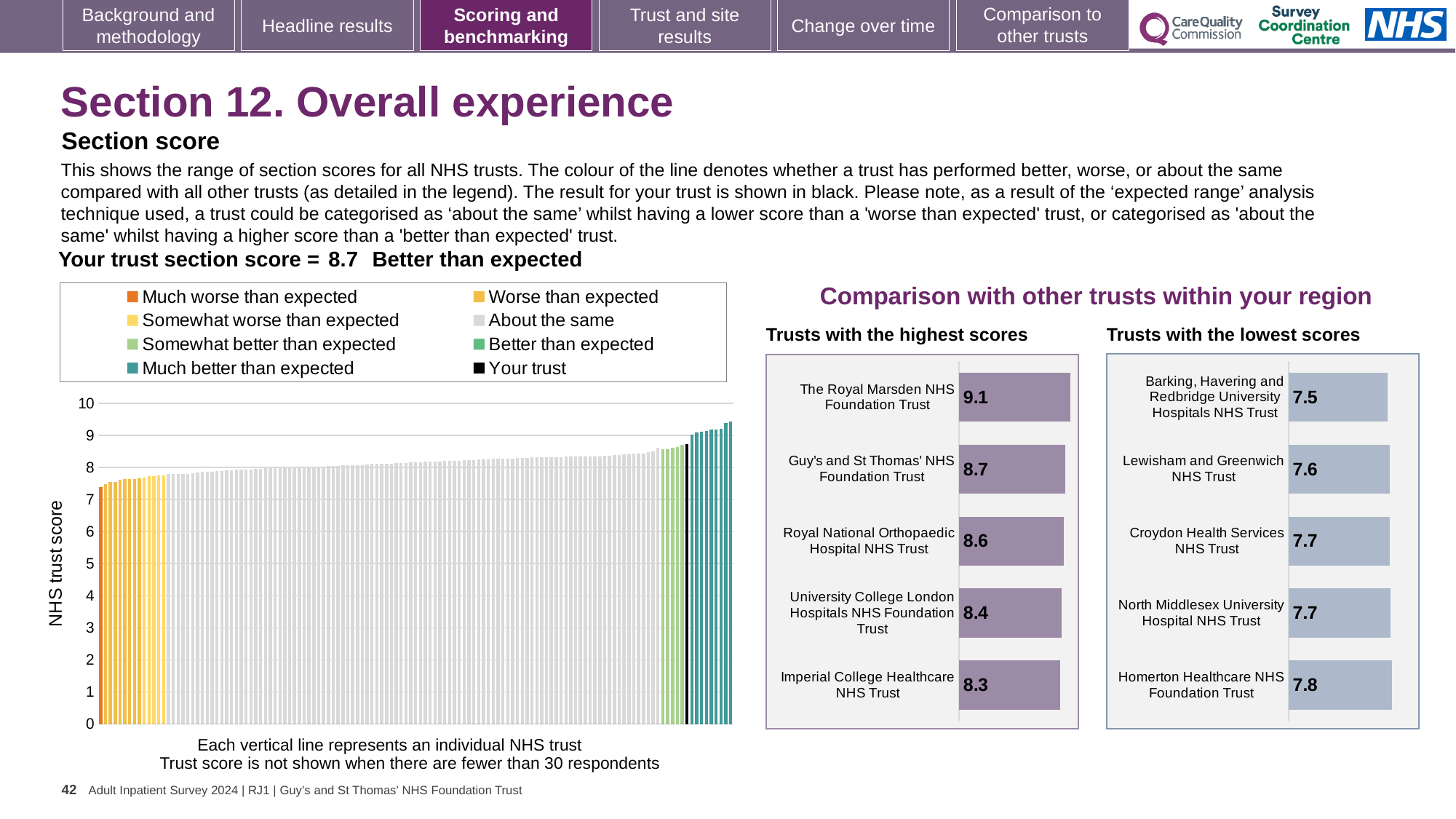
In the 'Trusts with the highest scores' chart, what is the difference between the scores of The Royal Marsden NHS Foundation Trust and Imperial College Healthcare NHS Trust? 0.8 In the 'Trusts with the highest scores' chart, what is the score for The Royal Marsden NHS Foundation Trust? 9.1 How many trusts are shown in the 'Trusts with the highest scores' chart? 5 In the 'Trusts with the lowest scores' chart, what is the score for Barking, Havering and Redbridge University Hospitals NHS Trust? 7.5 In the 'NHS trust score' chart on the left, do the values rise or fall from left to right along the x axis? Rise What type of chart is the 'NHS trust score' chart on the left of the slide? Bar chart In the 'Trusts with the lowest scores' chart, which trust has the highest score shown? Homerton Healthcare NHS Foundation Trust In the 'NHS trust score' chart on the left, what colour represents 'Your trust' in the legend? Black How many entries does the legend of the 'NHS trust score' chart on the left list? 8 In the 'Trusts with the highest scores' chart, which trust has the lowest score shown? Imperial College Healthcare NHS Trust In the 'Trusts with the lowest scores' chart, which has the larger score: Lewisham and Greenwich NHS Trust or Homerton Healthcare NHS Foundation Trust? Homerton Healthcare NHS Foundation Trust In the 'Trusts with the lowest scores' chart, what score is shown for Croydon Health Services NHS Trust? 7.7